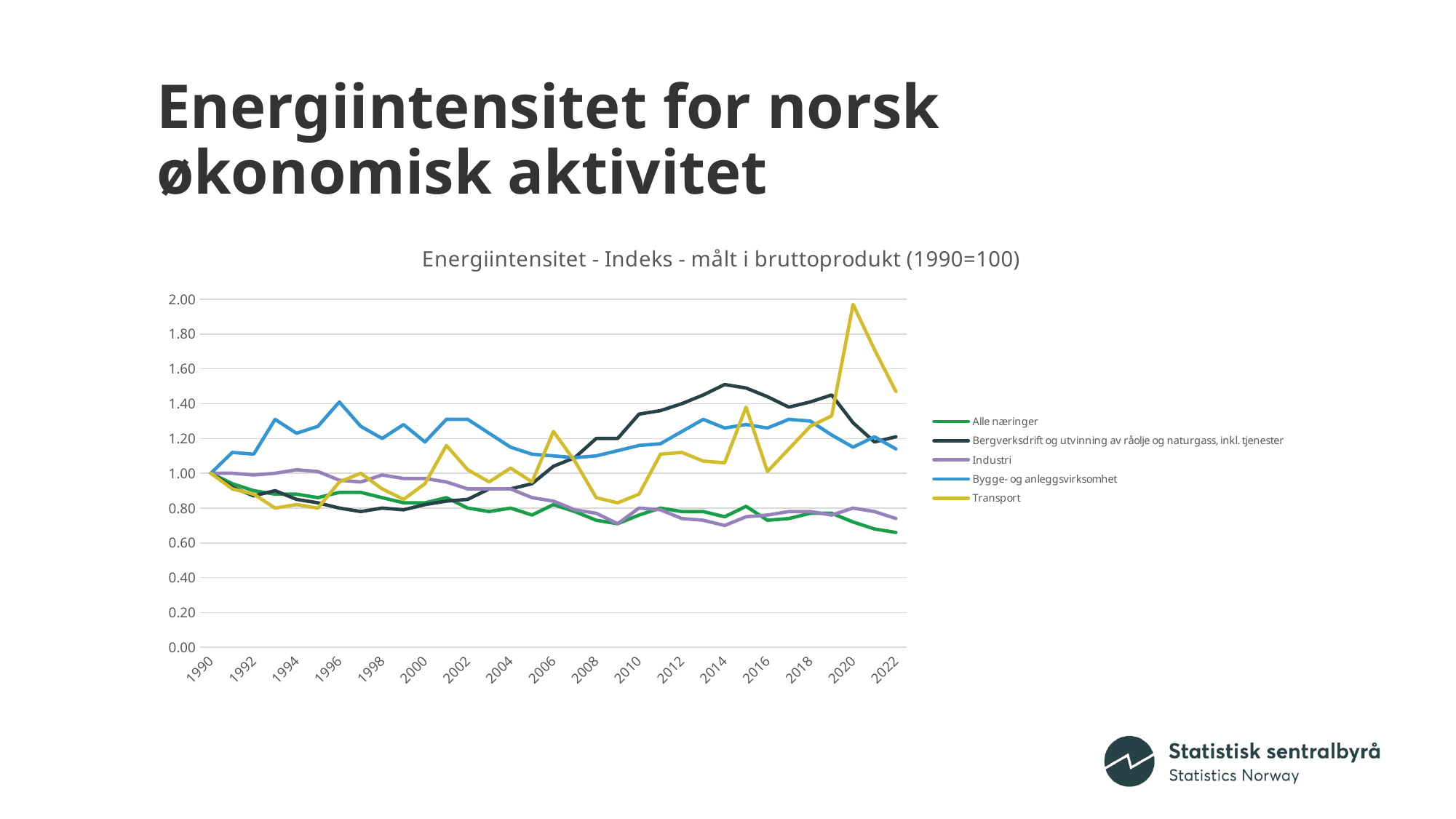
Which colour is used for the Transport series? yellow Which series has the highest value in 2020? Transport Which series has the lowest value in 2022? Alle næringer Is the value for Alle næringer in 2022 greater or less than 0.80? less What kind of chart is shown on the slide? line chart Is the value for Bergverksdrift og utvinning av råolje og naturgass, inkl. tjenester in 2014 greater or less than 1.40? greater What is the title of the chart? Energiintensitet - Indeks - målt i bruttoprodukt (1990=100) Is the value for Transport in 2020 greater or less than 1.80? greater Does the Alle næringer series generally rise or fall from 1990 to 2022? fall What is the index value of all series in 1990? 1.00 How many series does the legend list? 5 Which is larger in 2020, the value for Transport or the value for Industri? Transport